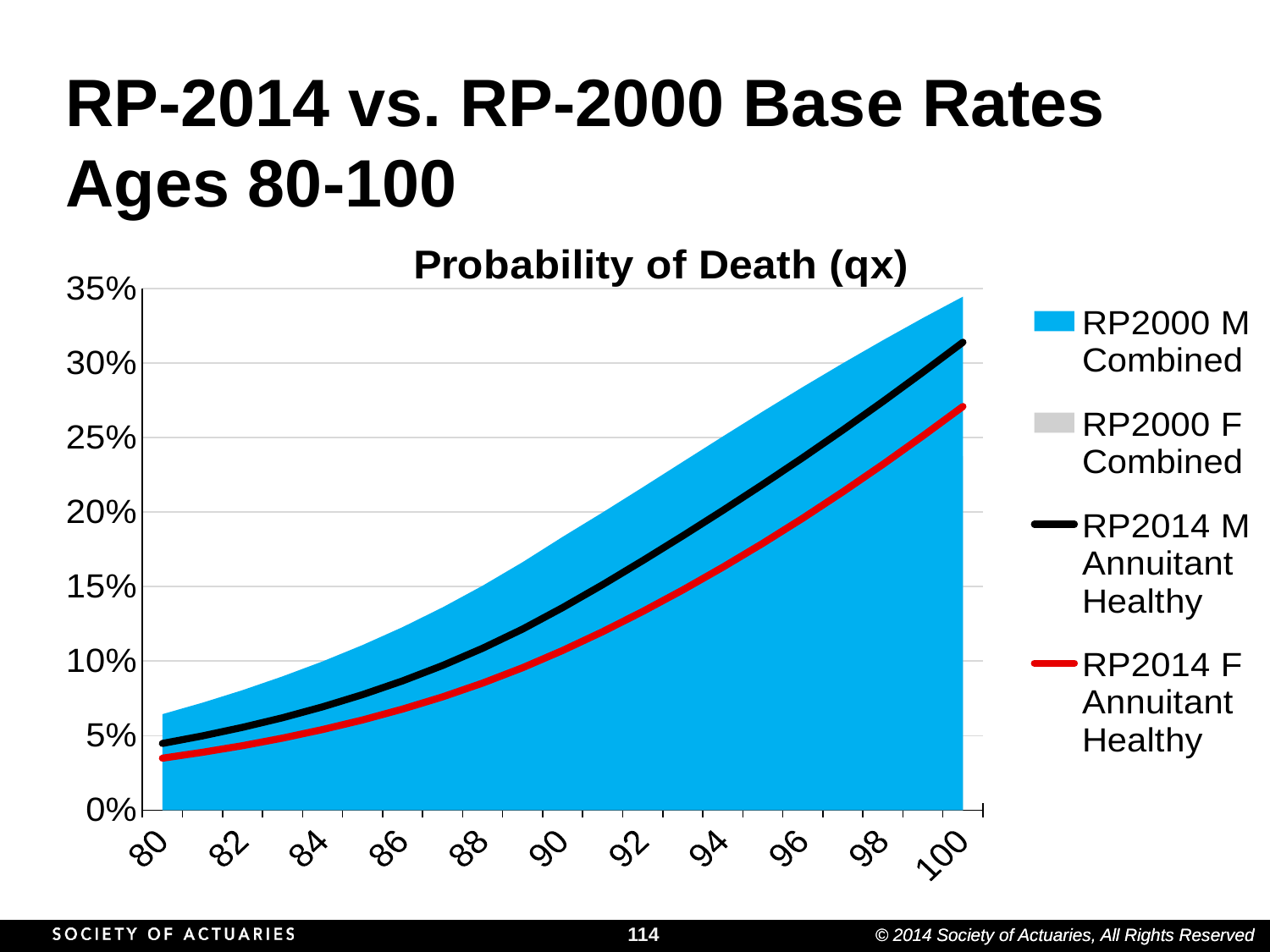
How many series does the chart legend list? 4 Is the value for RP2014 M Annuitant Healthy at age 96 greater or less than 20%? greater Which series is drawn as a red line? RP2014 F Annuitant Healthy Which series has the lowest value at age 80? RP2014 F Annuitant Healthy At age 100, which is larger: RP2014 M Annuitant Healthy or RP2014 F Annuitant Healthy? RP2014 M Annuitant Healthy Is the value for RP2000 M Combined at age 80 greater or less than 5%? greater Which series has the highest value at age 100? RP2000 M Combined Is the value for RP2014 M Annuitant Healthy at age 100 greater or less than 30%? greater What is the title of the chart? Probability of Death (qx) Do the probability of death values rise or fall as age increases from 80 to 100? rise